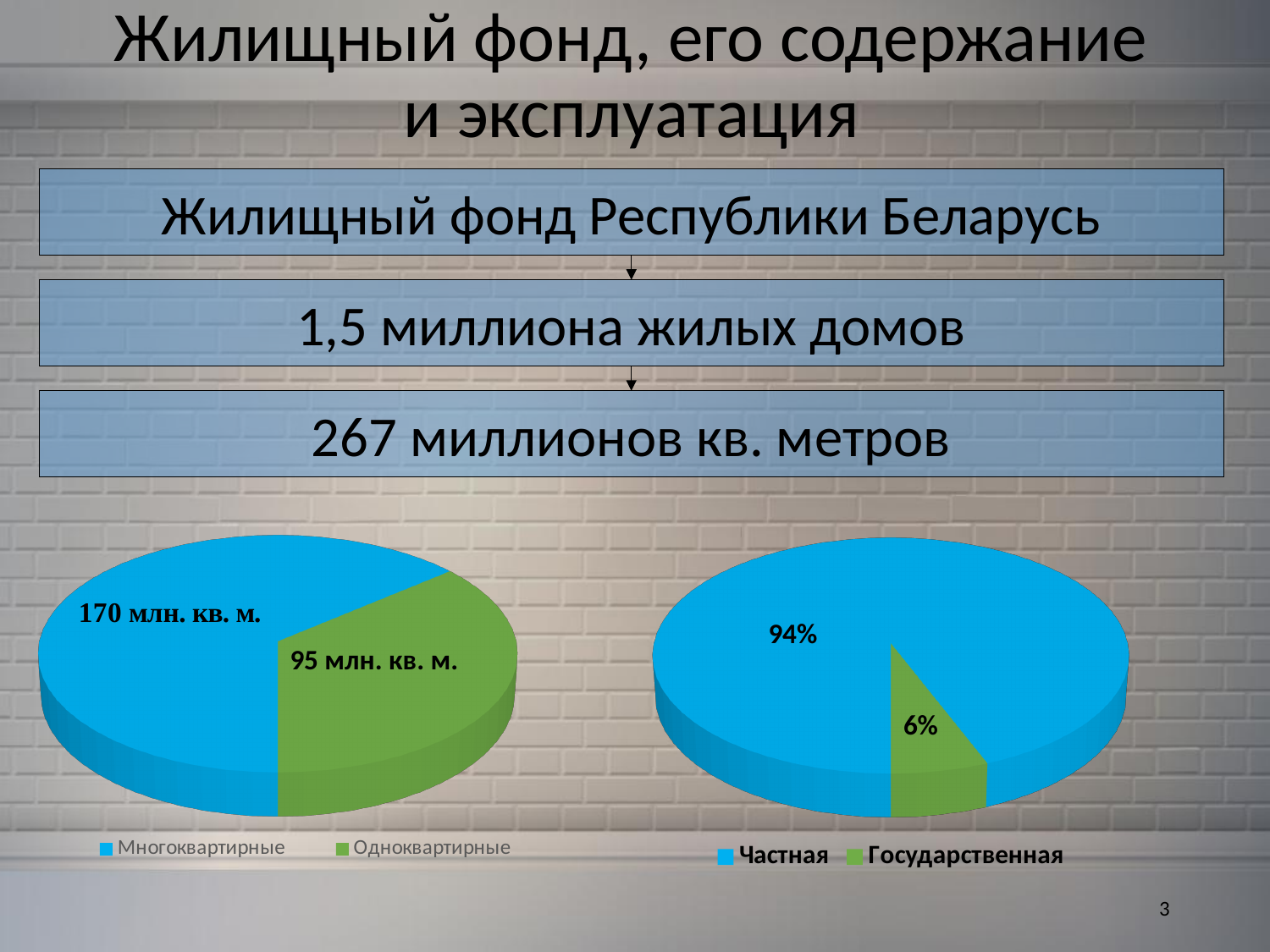
In the left pie chart, what is the value for Одноквартирные? 95 млн. кв. м. In the right pie chart, which category has the smallest slice? Государственная How many entries does the legend of the right pie chart list? 2 In the left pie chart, what is the value for Многоквартирные? 170 млн. кв. м. How many slices does the left pie chart have? 2 In the left pie chart, what is the difference between the values for Многоквартирные and Одноквартирные? 75 млн. кв. м. In the left pie chart, which category has the largest slice? Многоквартирные In the right pie chart, what share is labelled for Государственная? 6% What type of chart is the chart on the right of the slide? Pie chart In the left pie chart, what colour is the Одноквартирные slice? Green In the right pie chart, what share is labelled for Частная? 94% In the right pie chart, which is larger, Частная or Государственная? Частная